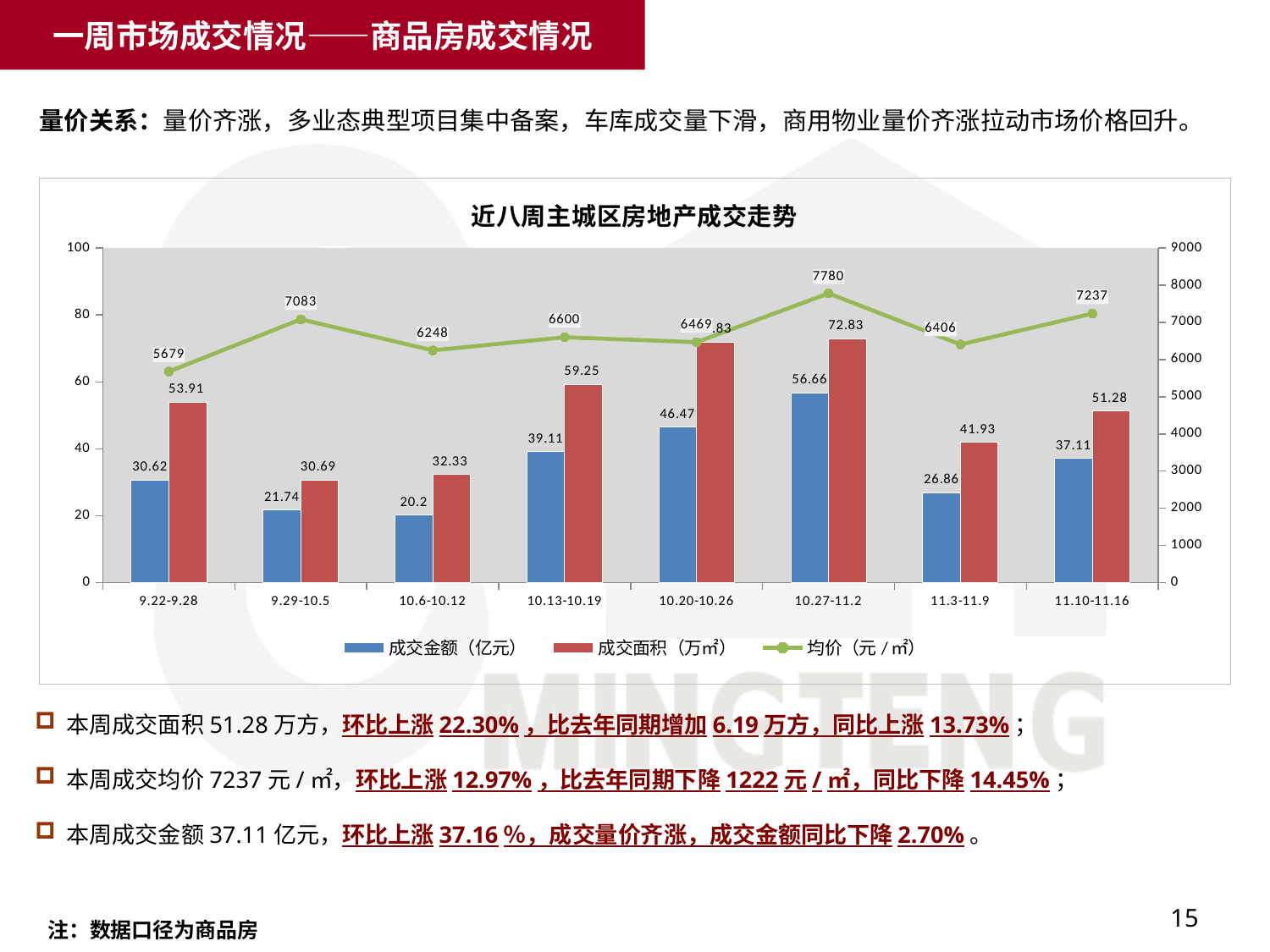
Which period has the highest 均价（元/㎡）? 10.27-11.2 Which period has the lowest 成交金额（亿元）? 10.6-10.12 What is the 成交面积（万㎡） value for 10.13-10.19? 59.25 What is the 均价（元/㎡） value for 9.22-9.28? 5679 How many series does the legend list? 3 Does the 成交金额（亿元） rise or fall from 10.27-11.2 to 11.3-11.9? Fall Which is larger, the 均价（元/㎡） for 9.29-10.5 or for 11.10-11.16? 11.10-11.16 What is the difference between the 成交面积（万㎡） values for 11.10-11.16 and 11.3-11.9? 9.35 How many periods are shown on the x axis? 8 What is the title of the chart? 近八周主城区房地产成交走势 What kind of chart is this? Combined bar and line chart What is the 成交金额（亿元） value for 10.27-11.2? 56.66